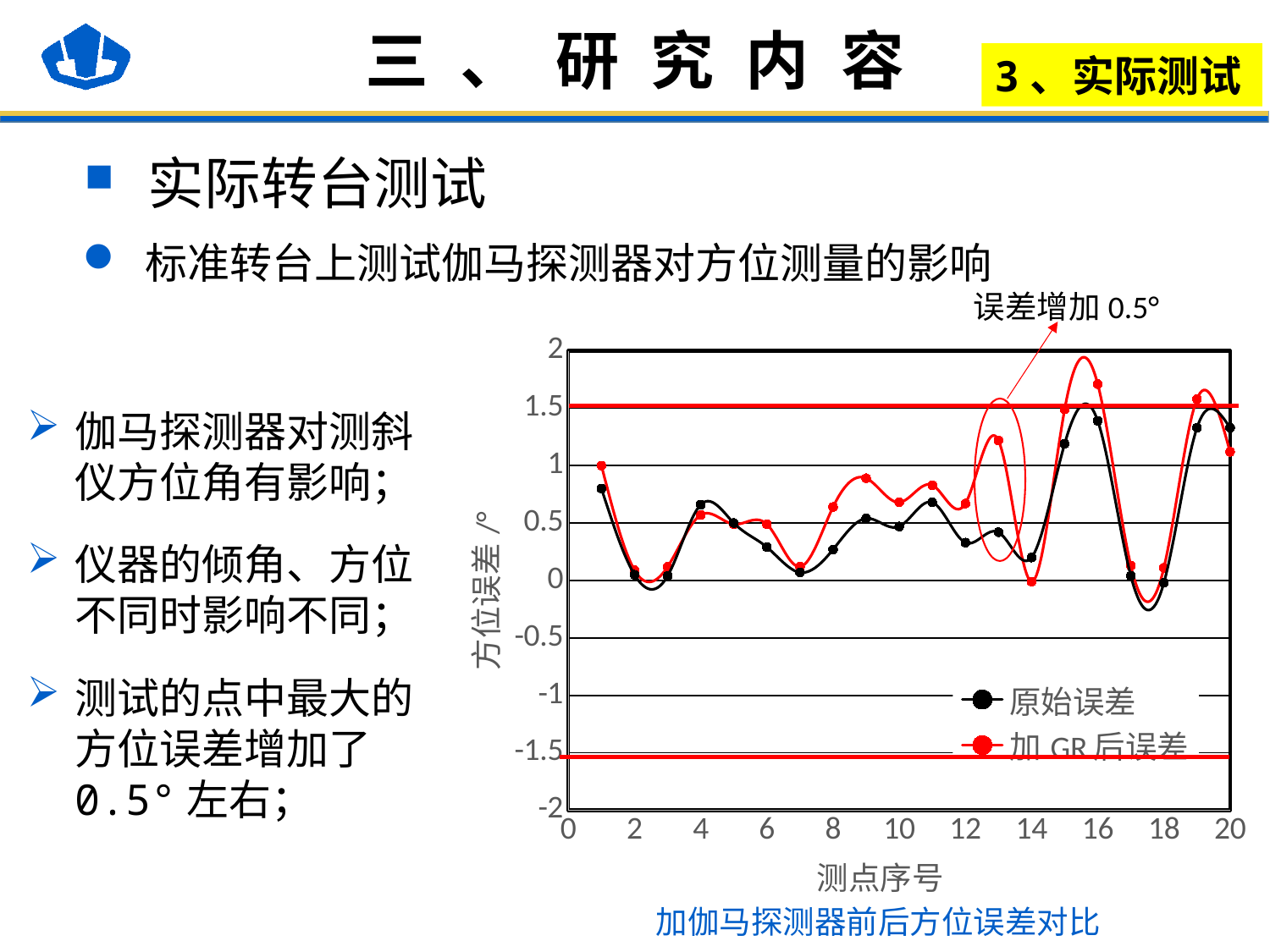
At measurement point 9, which series has the larger value, 原始误差 or 加 GR 后误差? 加 GR 后误差 What kind of chart is shown on the slide? line chart Is the 原始误差 value at measurement point 7 greater or less than 0.5? less Is the 加 GR 后误差 value at measurement point 16 greater or less than 1.5? greater How many series does the chart legend list? 2 At measurement point 13, which series has the larger value, 原始误差 or 加 GR 后误差? 加 GR 后误差 Is the 原始误差 value at measurement point 16 greater or less than 1.5? less How many measurement points are plotted for each series in the chart? 20 What is the x-axis title of the chart? 测点序号 What are the two series named in the chart legend? 原始误差 and 加 GR 后误差